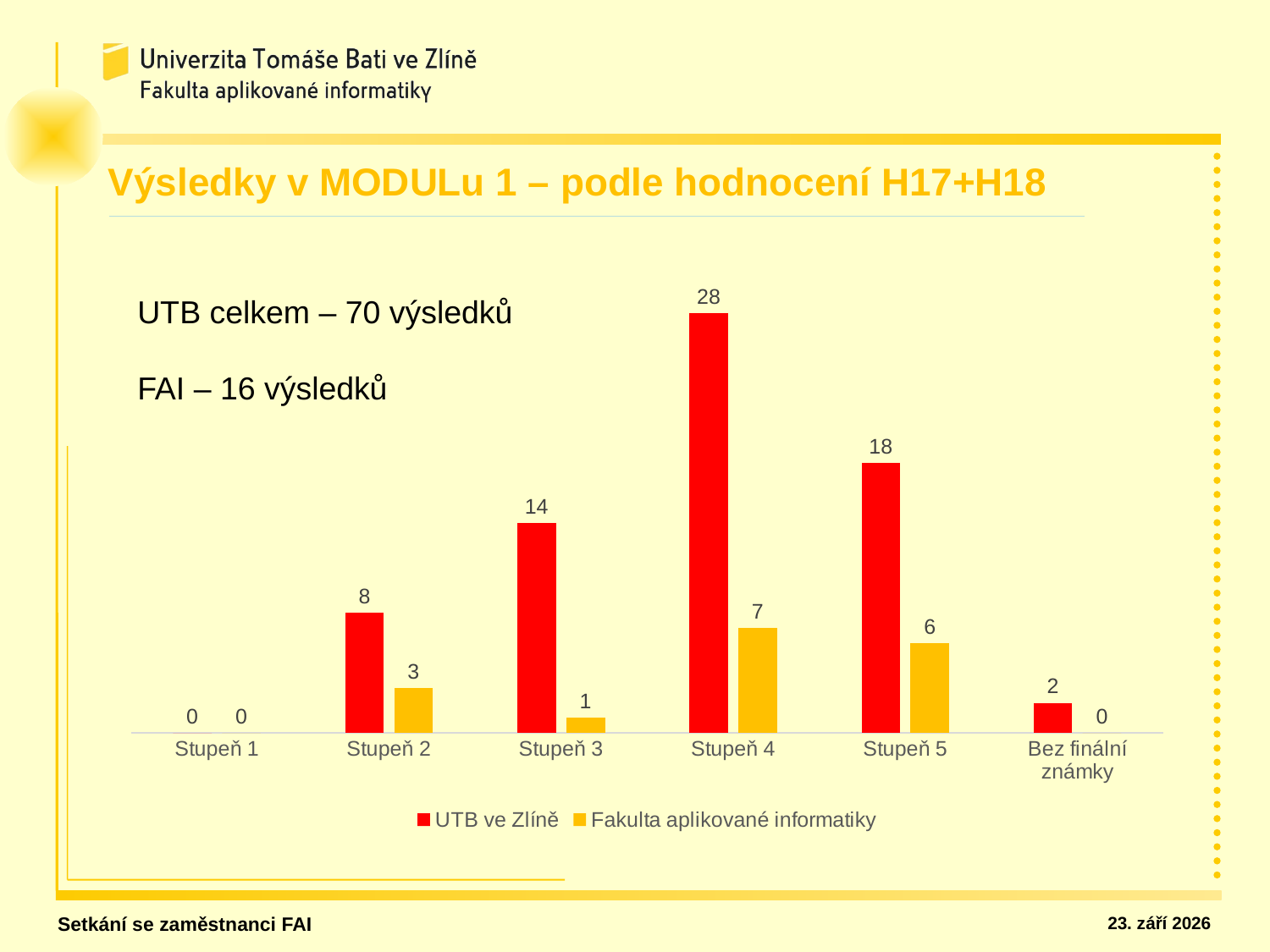
What is the difference between the UTB ve Zlíně and Fakulta aplikované informatiky values at Stupeň 5? 12 What is the value for Fakulta aplikované informatiky at Stupeň 2? 3 What kind of chart is shown on the slide? Bar chart Which category has the highest value for UTB ve Zlíně? Stupeň 4 What is the difference between the UTB ve Zlíně values at Stupeň 4 and Stupeň 3? 14 How many series does the legend list? 2 Which colour represents Fakulta aplikované informatiky in the chart? Yellow Which category has the highest value for Fakulta aplikované informatiky? Stupeň 4 Which is larger: the UTB ve Zlíně value at Stupeň 3 or at Stupeň 5? Stupeň 5 What is the value for UTB ve Zlíně at Stupeň 4? 28 How many categories are shown on the x axis? 6 What is the value for UTB ve Zlíně in the Bez finální známky category? 2